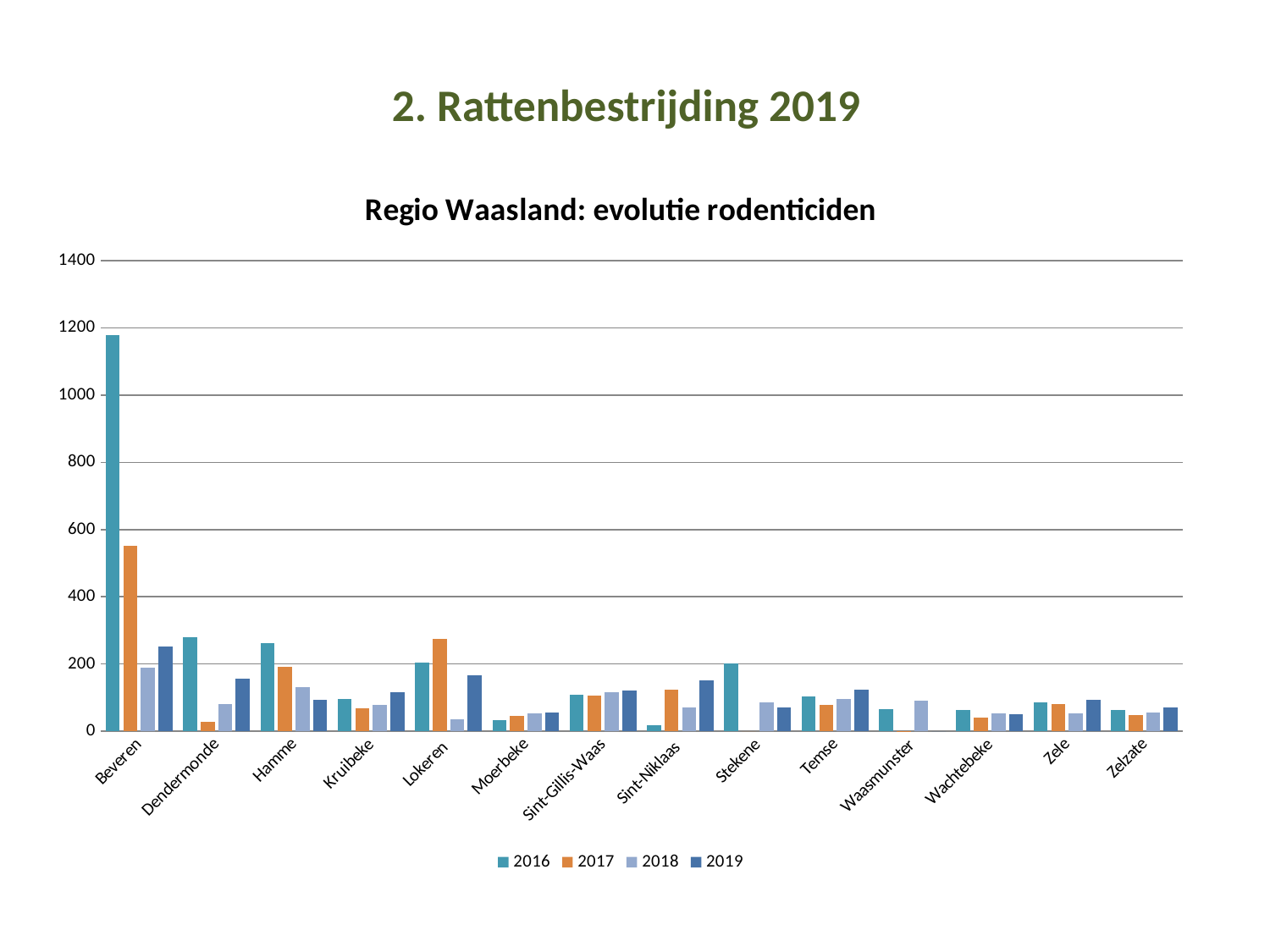
How many municipalities are shown on the x axis? 14 Which municipality has the highest value for 2016? Beveren Is the value for Moerbeke in 2016 greater or less than 100? less What kind of chart is shown on the slide? bar chart For Lokeren, which year has the larger value, 2016 or 2017? 2017 Is the value for Beveren in 2016 greater or less than 1000? greater For Hamme, which year has the larger value, 2016 or 2019? 2016 What is the title of the chart? Regio Waasland: evolutie rodenticiden Is the value for Beveren in 2017 greater or less than 400? greater Which municipality has the highest value for 2017? Beveren How many series does the legend list? 4